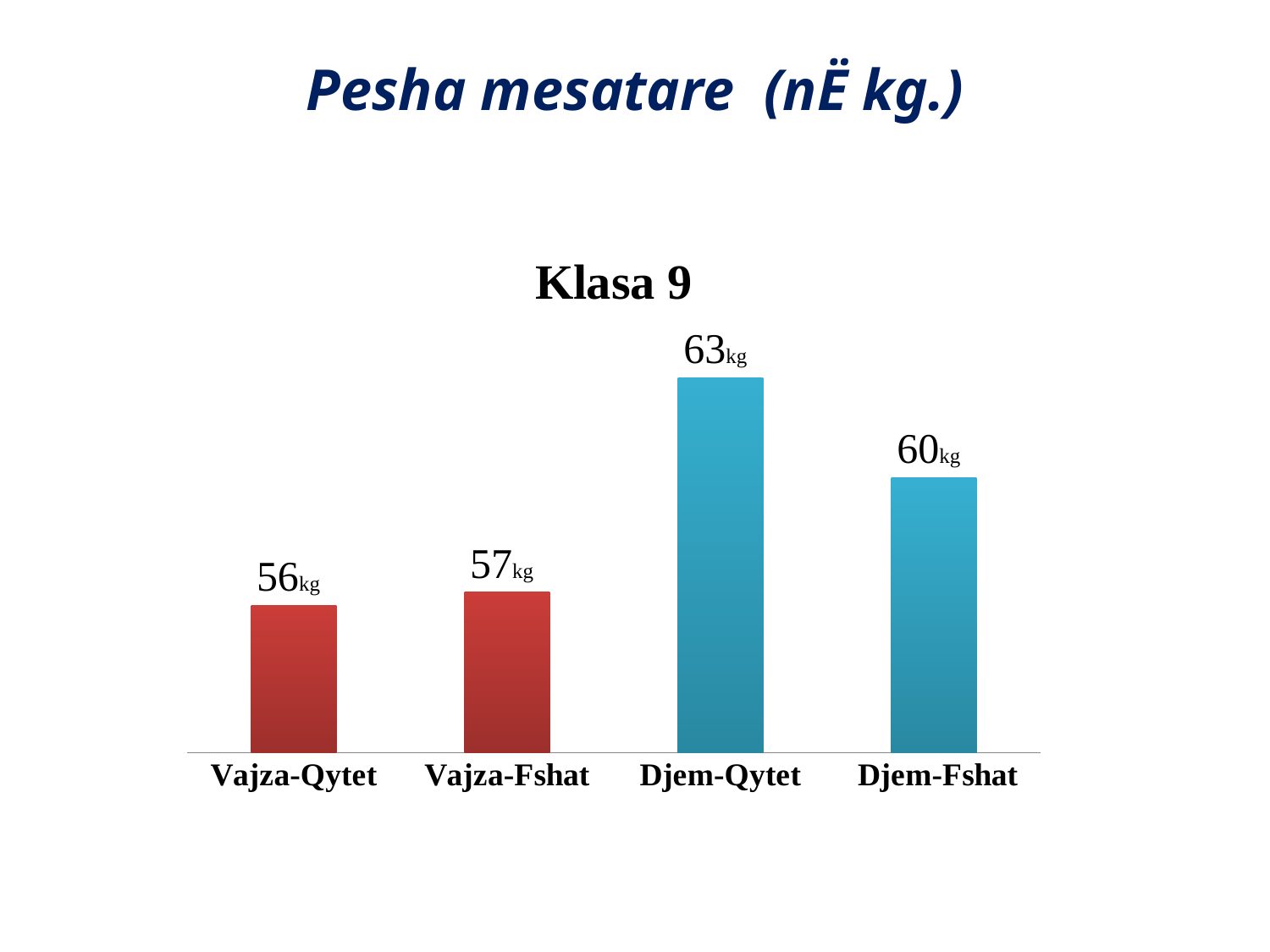
What is the value for Djem-Qytet? 63kg Which category has the lowest value? Vajza-Qytet What is the difference between the values for Djem-Qytet and Djem-Fshat? 3kg Which category has the highest value? Djem-Qytet Which is larger, the value for Djem-Fshat or the value for Vajza-Fshat? Djem-Fshat What is the value for Vajza-Qytet? 56kg What kind of chart is shown on the slide? bar chart What is the difference between the values for Djem-Fshat and Vajza-Qytet? 4kg What is the value for Vajza-Fshat? 57kg How many categories are shown in the chart? 4 What is the value for Djem-Fshat? 60kg What is the title of the chart? Klasa 9